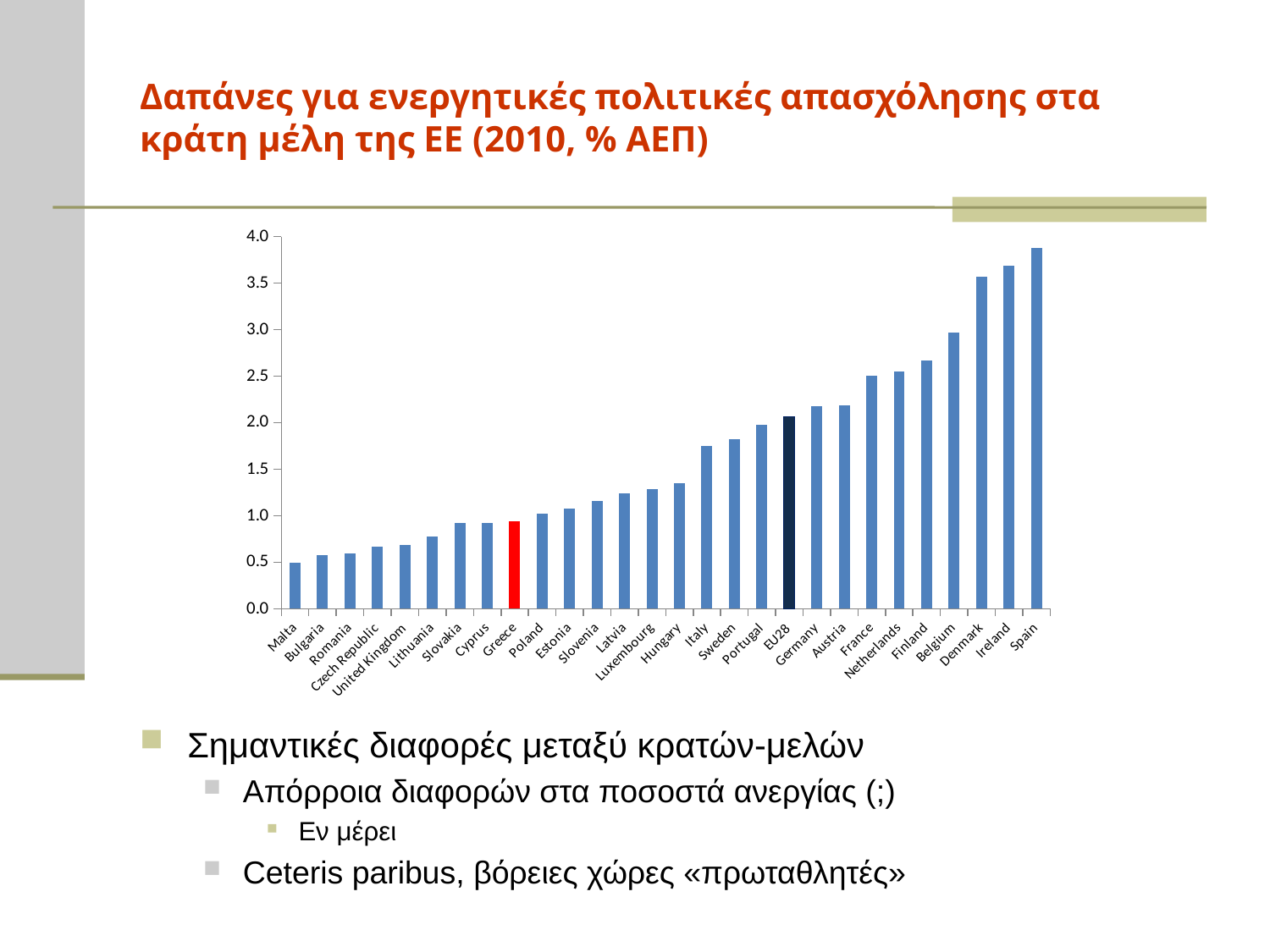
Which country's bar is coloured red in the chart? Greece What kind of chart is shown on the slide? bar chart Which has a larger value, Greece or Germany? Germany Which category has the highest value in the chart? Spain Is the value for Malta greater or less than 1.0? less How many countries/categories are plotted on the x axis of the chart? 28 Which category has the lowest value in the chart? Malta Is the value for Greece greater or less than 1.0? less Which has a larger value, Denmark or Italy? Denmark Is the value for EU28 greater or less than 2.0? greater Do the values rise or fall moving from left to right along the x axis? rise